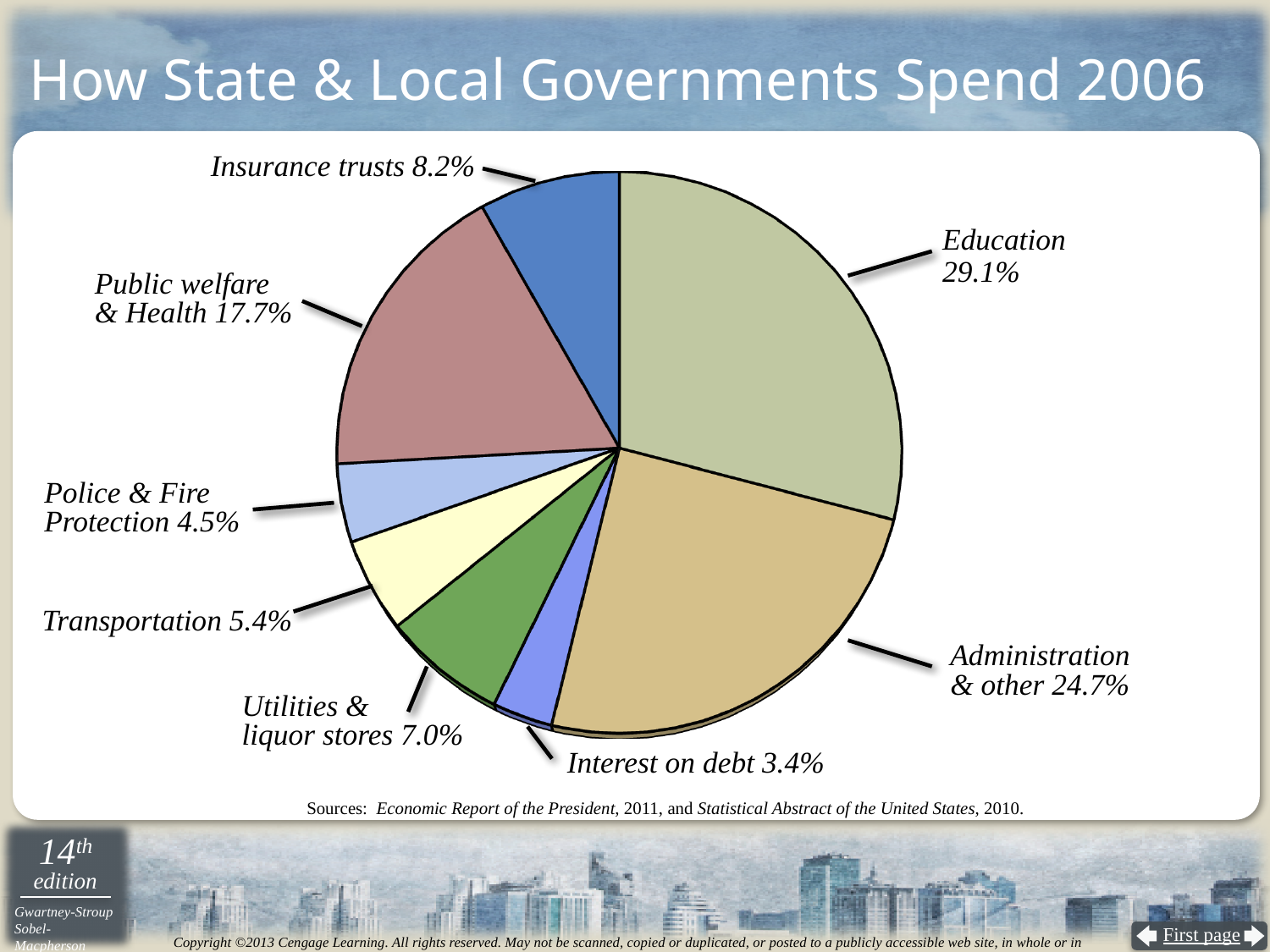
What percentage is shown for Interest on debt? 3.4% Which category has the largest share of spending? Education What is the difference in percentage points between Education and Administration & other? 4.4 What is the difference in percentage points between Public welfare & Health and Police & Fire Protection? 13.2 Which is larger, the share for Insurance trusts or the share for Transportation? Insurance trusts What percentage is shown for Utilities & liquor stores? 7.0% Which category has the smallest share of spending? Interest on debt How many categories are shown in the pie chart? 8 What share of state and local government spending goes to Education? 29.1% What kind of chart is shown on the slide? pie chart What percentage is shown for Public welfare & Health? 17.7% What is the title of the chart? How State & Local Governments Spend 2006